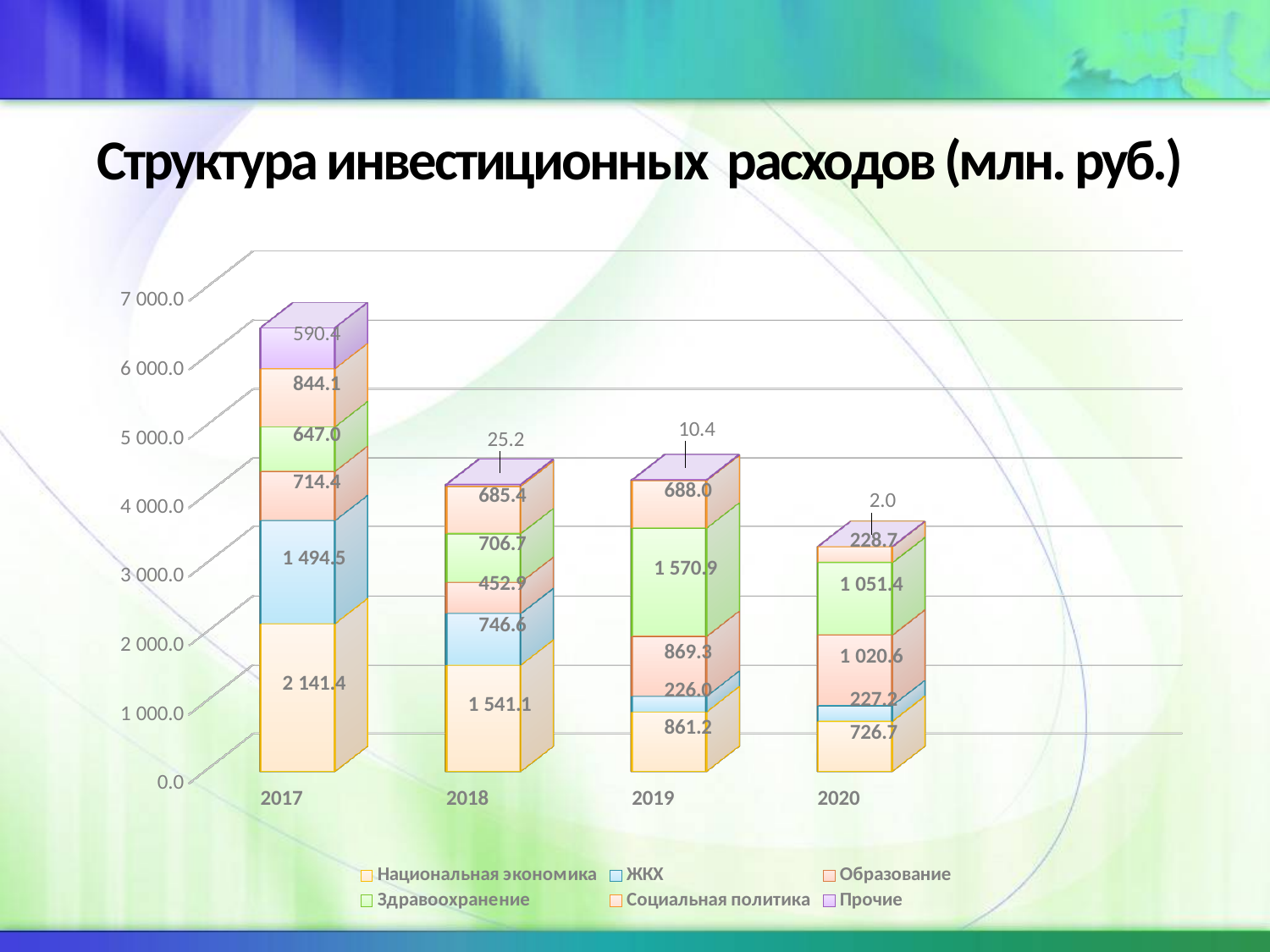
What is the value for Здравоохранение in 2019? 1 570.9 What is the difference between the Национальная экономика values for 2017 and 2018? 600.3 What is the value for ЖКХ in 2018? 746.6 In which year is the value for Национальная экономика the lowest? 2020 How many years are shown on the x axis? 4 How many series does the legend list? 6 In which year is the value for ЖКХ the highest? 2017 In 2020, which is larger: Образование or Здравоохранение? Здравоохранение What is the value for Прочие in 2020? 2.0 What kind of chart is shown on the slide? Stacked bar chart What is the value for Национальная экономика in 2017? 2 141.4 Does the value for Прочие rise or fall from 2017 to 2020? Falls